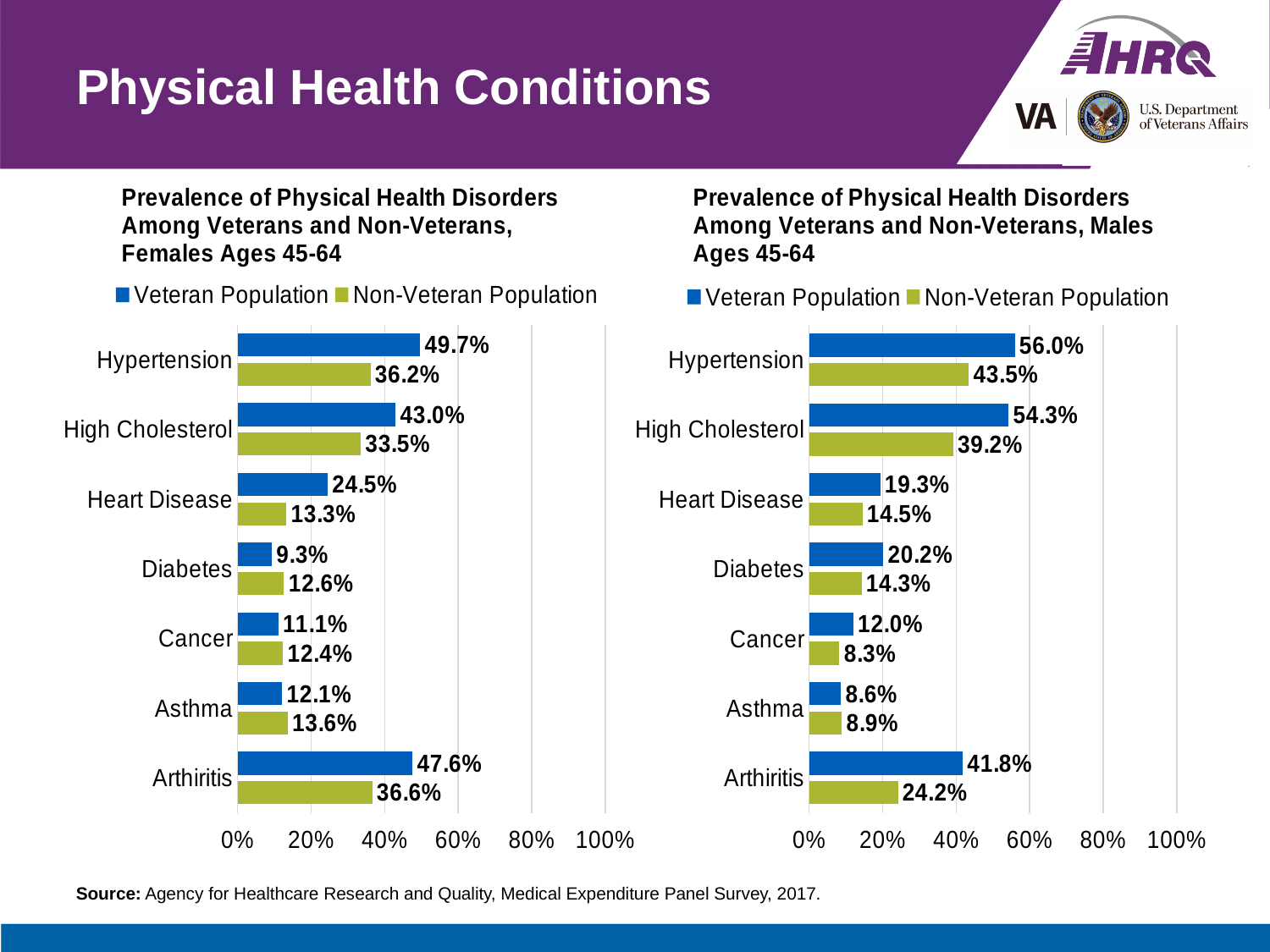
In the Males Ages 45-64 chart, which condition has the highest Veteran Population value? Hypertension In the Females Ages 45-64 chart, what is the Veteran Population value for Hypertension? 49.7% How many health conditions are listed in the Females Ages 45-64 chart? 7 In the Females Ages 45-64 chart, what is the difference between the Veteran and Non-Veteran Population values for Hypertension? 13.5% What type of chart is the Females Ages 45-64 chart? Bar chart In the Males Ages 45-64 chart, which colour represents the Non-Veteran Population? Green In the Females Ages 45-64 chart, which is larger for Diabetes: the Veteran Population value or the Non-Veteran Population value? Non-Veteran Population In the Males Ages 45-64 chart, is the Veteran Population value for High Cholesterol greater or less than 40%? greater In the Females Ages 45-64 chart, which condition has the lowest Veteran Population value? Diabetes In the Males Ages 45-64 chart, what is the difference between the Veteran and Non-Veteran Population values for Arthiritis? 17.6% How many series does the legend of the Males Ages 45-64 chart list? 2 In the Males Ages 45-64 chart, what is the Non-Veteran Population value for High Cholesterol? 39.2%